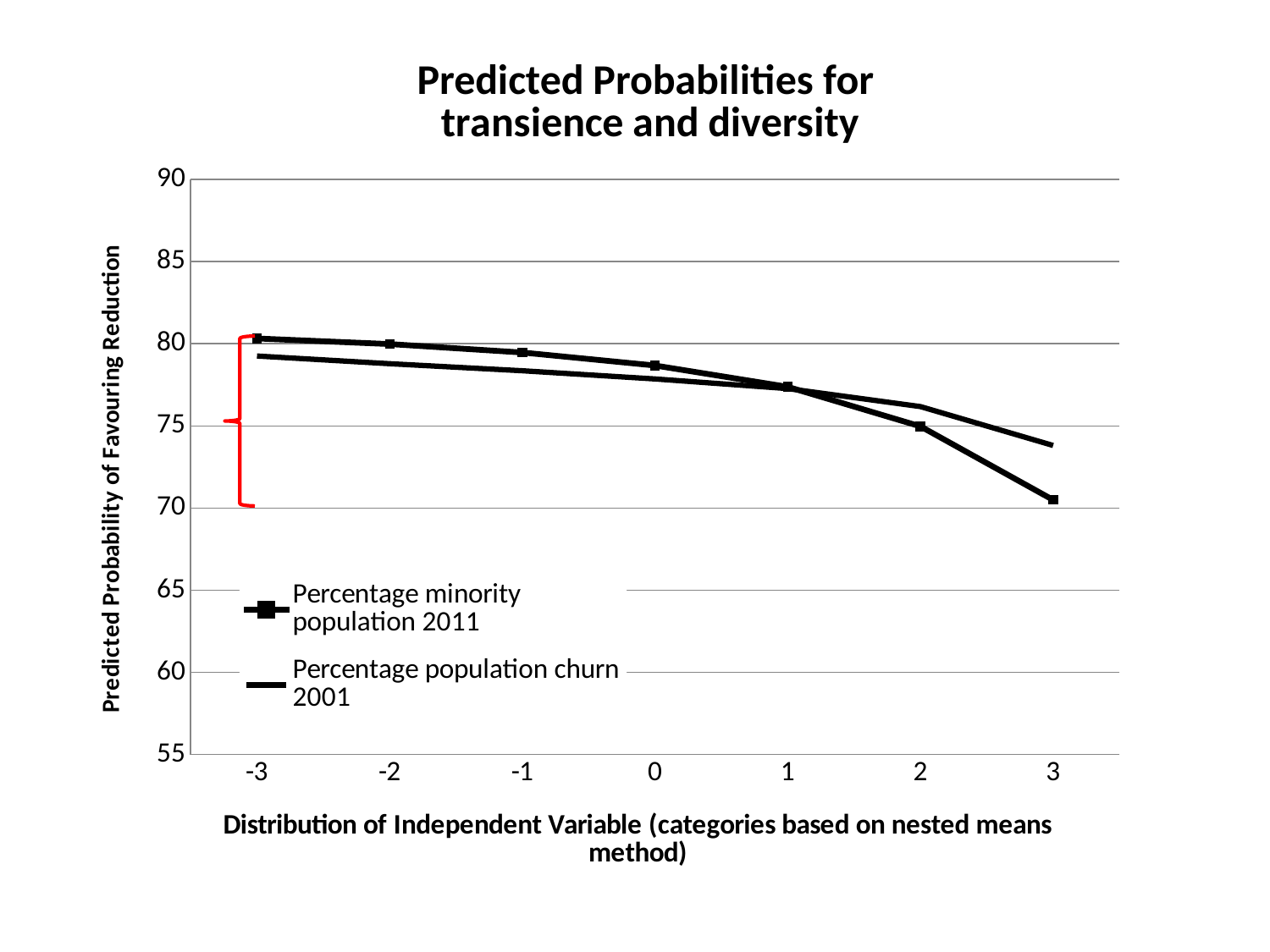
What is the title of the chart? Predicted Probabilities for transience and diversity What kind of chart is shown on the slide? line chart At which x-axis category is the value for Percentage minority population 2011 lowest? 3 How many categories are shown on the x axis? 7 Is the value for Percentage minority population 2011 at x = 3 greater or less than 75? less At x = 3, which series has the higher value: Percentage minority population 2011 or Percentage population churn 2001? Percentage population churn 2001 How many series does the legend list? 2 Do the values for Percentage minority population 2011 rise or fall as the x axis goes from -3 to 3? fall At x = -3, which series has the higher value: Percentage minority population 2011 or Percentage population churn 2001? Percentage minority population 2011 Is the value for Percentage population churn 2001 at x = 3 greater or less than 75? less At which x-axis category is the value for Percentage minority population 2011 highest? -3 Do the values for Percentage population churn 2001 rise or fall as the x axis goes from -3 to 3? fall